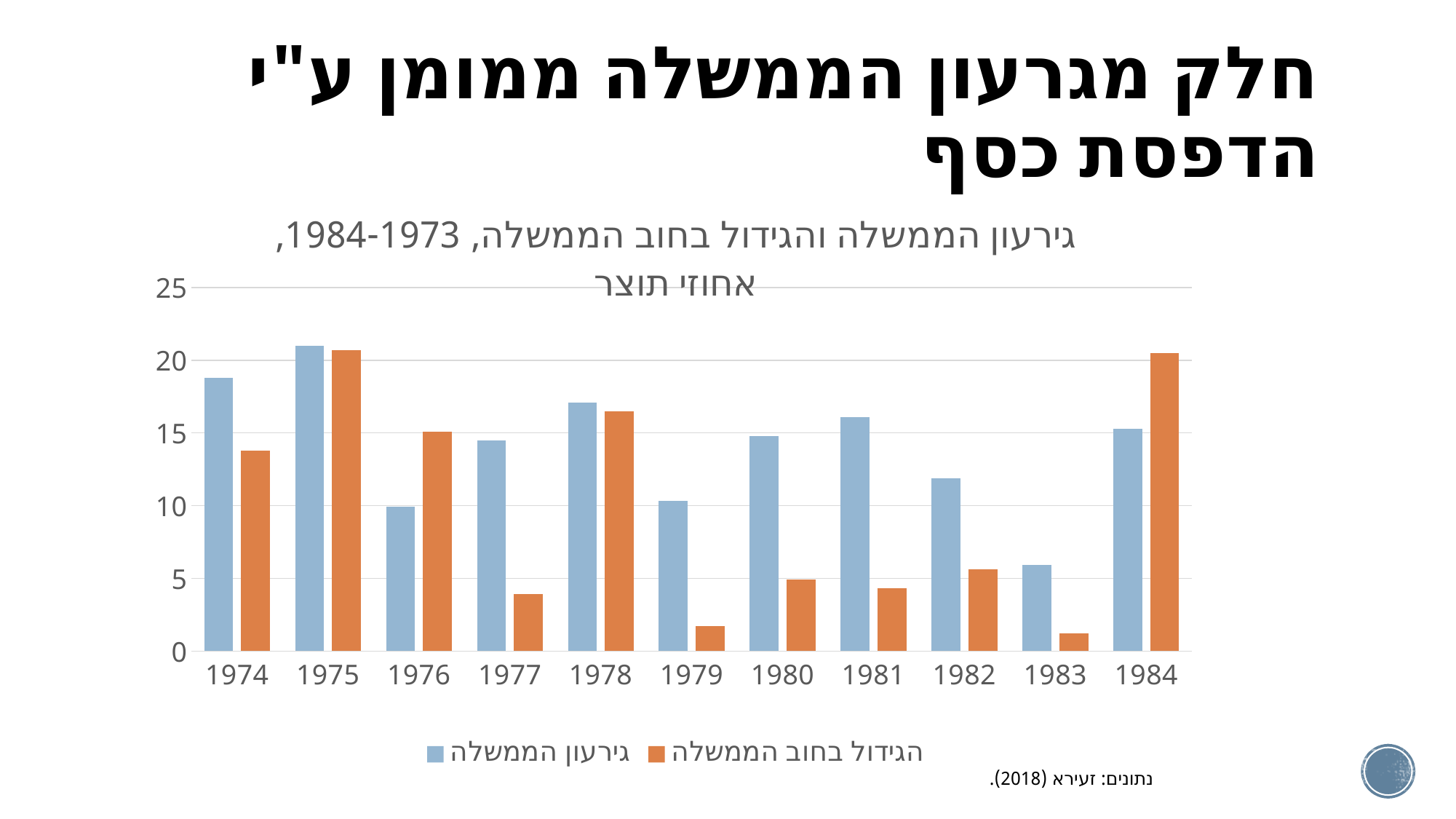
In which year is the orange series (הגידול בחוב הממשלה) lowest? 1983 What kind of chart is shown on the slide? bar chart Which colour represents the series גירעון הממשלה in the chart? blue Is the value of the orange series (הגידול בחוב הממשלה) for 1979 greater or less than 5? less How many years are shown on the x axis of the chart? 11 In which year is the blue series (גירעון הממשלה) lowest? 1983 Is the value of the blue series (גירעון הממשלה) for 1975 greater or less than 20? greater In 1984, which series is larger: the blue (גירעון הממשלה) or the orange (הגידול בחוב הממשלה)? orange (הגידול בחוב הממשלה) How many series does the chart's legend list? 2 In 1981, which series is larger: the blue (גירעון הממשלה) or the orange (הגידול בחוב הממשלה)? blue (גירעון הממשלה) In which year is the blue series (גירעון הממשלה) highest? 1975